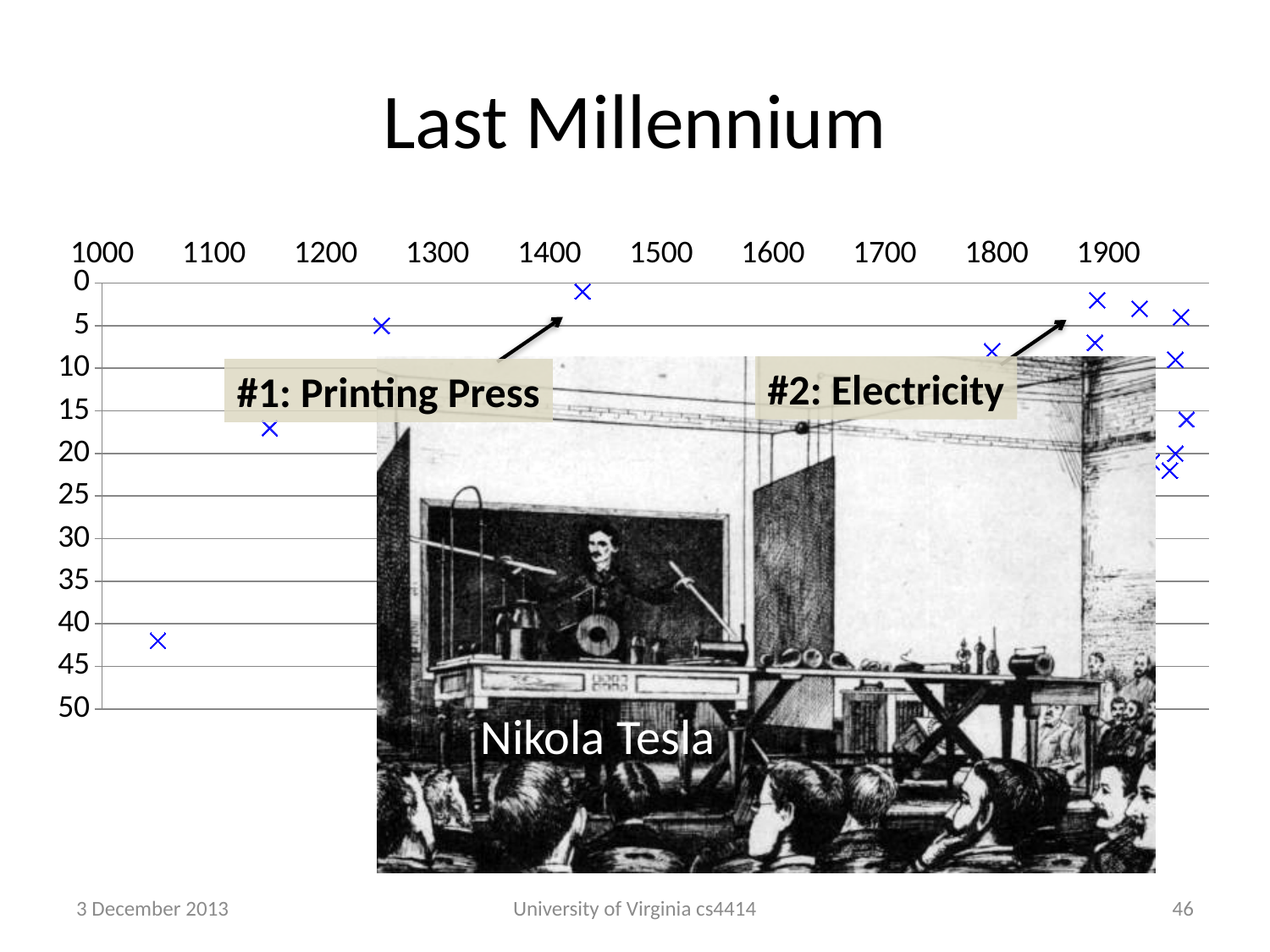
Between 1000 and 1400 on the x axis, do the plotted values rise or fall? fall Which has the larger value: the point plotted between 1000 and 1100 or the point plotted between 1100 and 1200? the point between 1000 and 1100 Is the value of the point plotted between 1100 and 1200 greater or less than 10? greater Which labelled point has the smallest value on the chart? #1: Printing Press Which two events are labelled with callouts on the chart? #1: Printing Press and #2: Electricity Is the value of the point plotted between 1000 and 1100 greater or less than 30? greater What is the title of the chart on the slide? Last Millennium Is the value of the point labelled '#1: Printing Press' greater or less than 5? less What kind of chart is shown on the slide? scatter chart